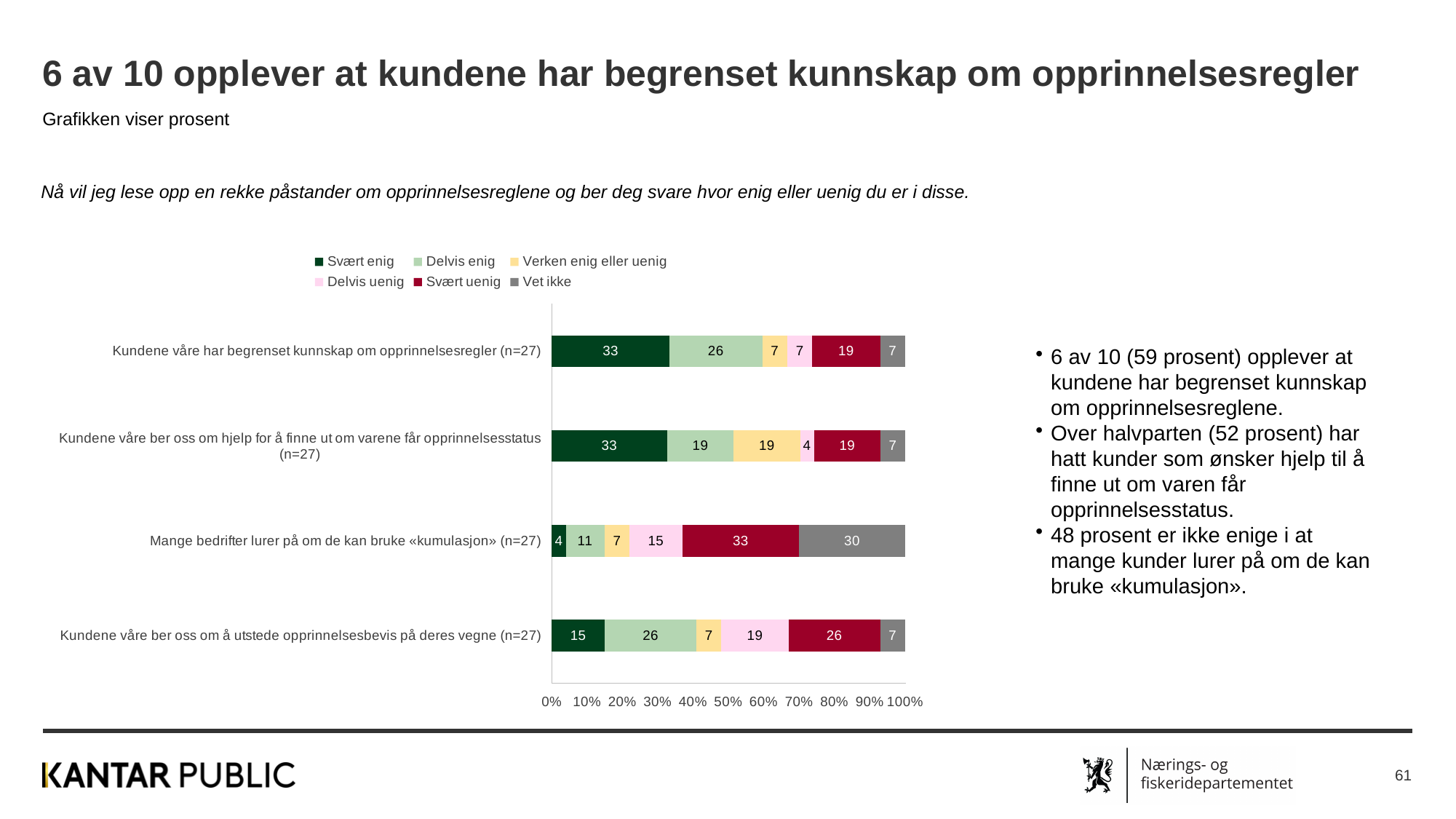
What is the 'Vet ikke' value for 'Mange bedrifter lurer på om de kan bruke «kumulasjon»'? 30 How many statements (categories) are plotted in the chart? 4 Which statement has the lowest 'Svært enig' value? Mange bedrifter lurer på om de kan bruke «kumulasjon» Which statement has the highest 'Svært uenig' value? Mange bedrifter lurer på om de kan bruke «kumulasjon» What is the difference between the 'Svært uenig' values for 'Mange bedrifter lurer på om de kan bruke «kumulasjon»' and 'Kundene våre har begrenset kunnskap om opprinnelsesregler'? 14 What is the 'Svært enig' value for 'Kundene våre har begrenset kunnskap om opprinnelsesregler'? 33 What is the 'Verken enig eller uenig' value for 'Kundene våre ber oss om hjelp for å finne ut om varene får opprinnelsesstatus'? 19 What is the 'Delvis uenig' value for 'Kundene våre ber oss om å utstede opprinnelsesbevis på deres vegne'? 19 What is the combined 'Svært enig' and 'Delvis enig' total for 'Kundene våre ber oss om å utstede opprinnelsesbevis på deres vegne'? 41 What type of chart is shown on the slide? Stacked bar chart How many series does the legend list? 6 Which is larger: the 'Delvis enig' value for 'Kundene våre har begrenset kunnskap om opprinnelsesregler' or for 'Kundene våre ber oss om hjelp for å finne ut om varene får opprinnelsesstatus'? Kundene våre har begrenset kunnskap om opprinnelsesregler